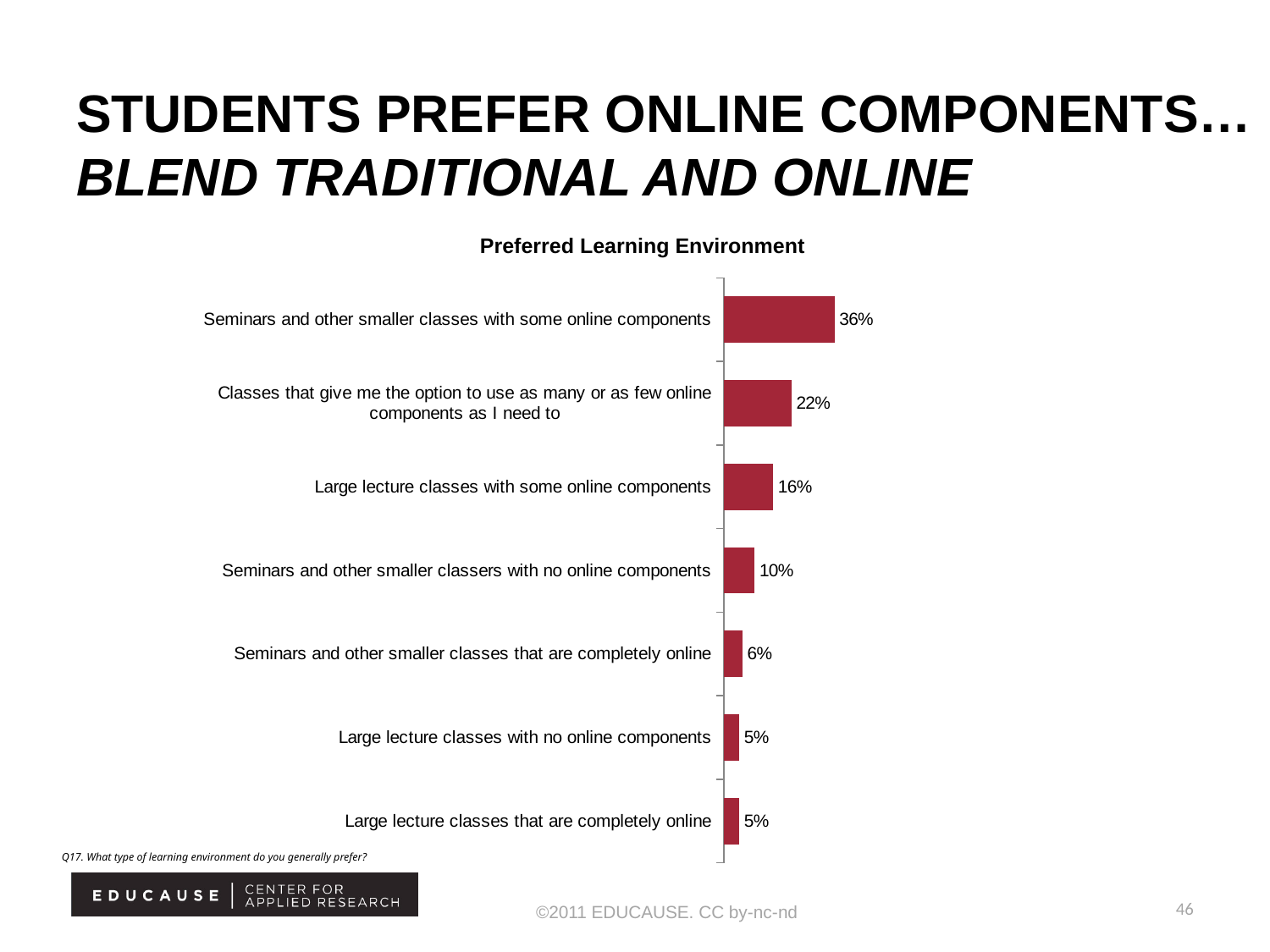
What is the difference between the values for "Large lecture classes with some online components" and "Seminars and other smaller classers with no online components"? 6% How many categories are shown in the chart? 7 Which category has the highest value? Seminars and other smaller classes with some online components What is the value for "Classes that give me the option to use as many or as few online components as I need to"? 22% What is the value for "Large lecture classes with some online components"? 16% What is the title of the chart? Preferred Learning Environment What is the difference between the values for "Seminars and other smaller classes with some online components" and "Classes that give me the option to use as many or as few online components as I need to"? 14% What is the value for "Large lecture classes with no online components"? 5% What is the value for "Seminars and other smaller classes with some online components"? 36% What kind of chart is shown on the slide? Bar chart Which is larger: the value for "Large lecture classes with some online components" or the value for "Seminars and other smaller classers with no online components"? Large lecture classes with some online components What is the value for "Seminars and other smaller classes that are completely online"? 6%